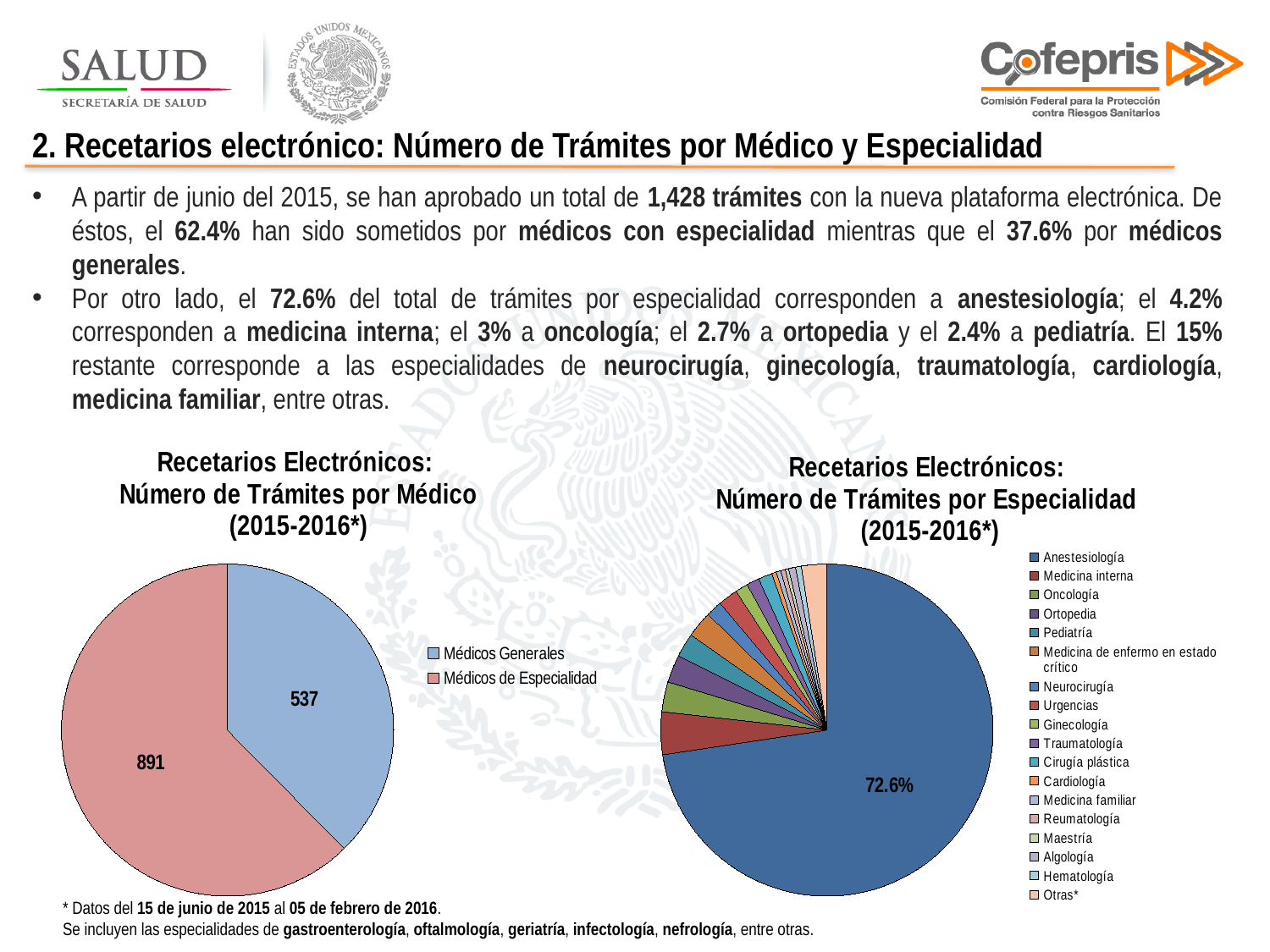
In the chart 'Número de Trámites por Médico', which category has the smaller value? Médicos Generales In the chart 'Número de Trámites por Especialidad', which specialty has the largest slice? Anestesiología In the chart 'Número de Trámites por Médico', what is the value for Médicos Generales? 537 What type of chart is 'Número de Trámites por Médico'? Pie chart In the chart 'Número de Trámites por Especialidad', which legend entry is listed last? Otras* In the chart 'Número de Trámites por Especialidad', what share is labeled for Anestesiología? 72.6% In the chart 'Número de Trámites por Médico', what is the difference between Médicos de Especialidad and Médicos Generales? 354 In the chart 'Número de Trámites por Médico', how many categories does the legend list? 2 In the chart 'Número de Trámites por Médico', what is the value for Médicos de Especialidad? 891 In the chart 'Número de Trámites por Médico', what is the total of the two slices? 1,428 In the chart 'Número de Trámites por Médico', which category has the larger value? Médicos de Especialidad In the chart 'Número de Trámites por Especialidad', how many categories does the legend list? 18